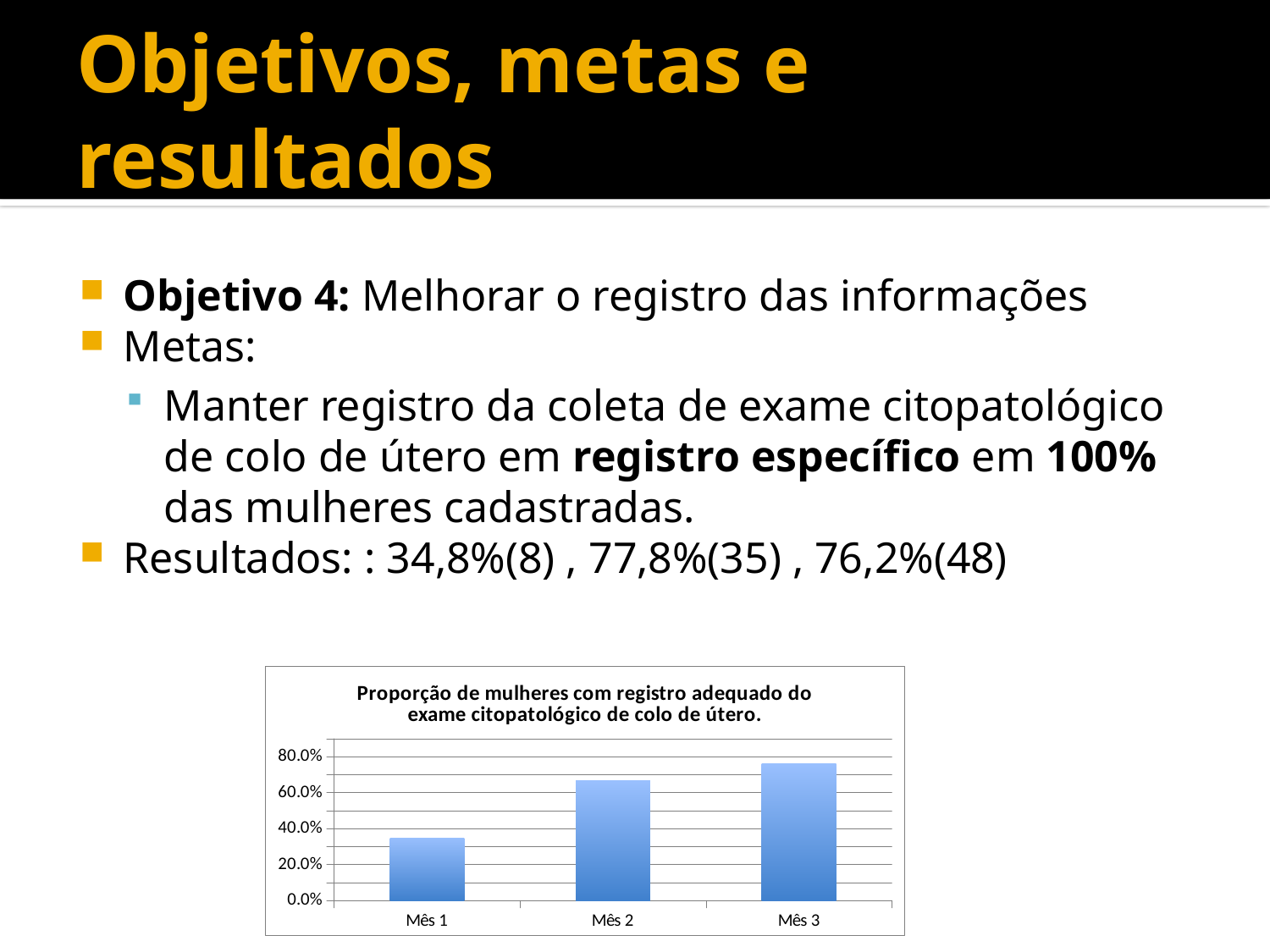
Which month has the lowest bar in the chart? Mês 1 Which is larger, the value for Mês 2 or the value for Mês 3? Mês 3 Is the value for Mês 3 greater or less than 80.0%? less Which month has the highest bar in the chart? Mês 3 Is the value for Mês 2 greater or less than 60.0%? greater Is the value for Mês 1 greater or less than 20.0%? greater How many categories (months) are shown on the x axis of the chart? 3 What is the title of the chart? Proporção de mulheres com registro adequado do exame citopatológico de colo de útero. What kind of chart is shown on the slide? bar chart Which is larger, the value for Mês 1 or the value for Mês 2? Mês 2 Do the values in the chart rise or fall from Mês 1 to Mês 3? rise